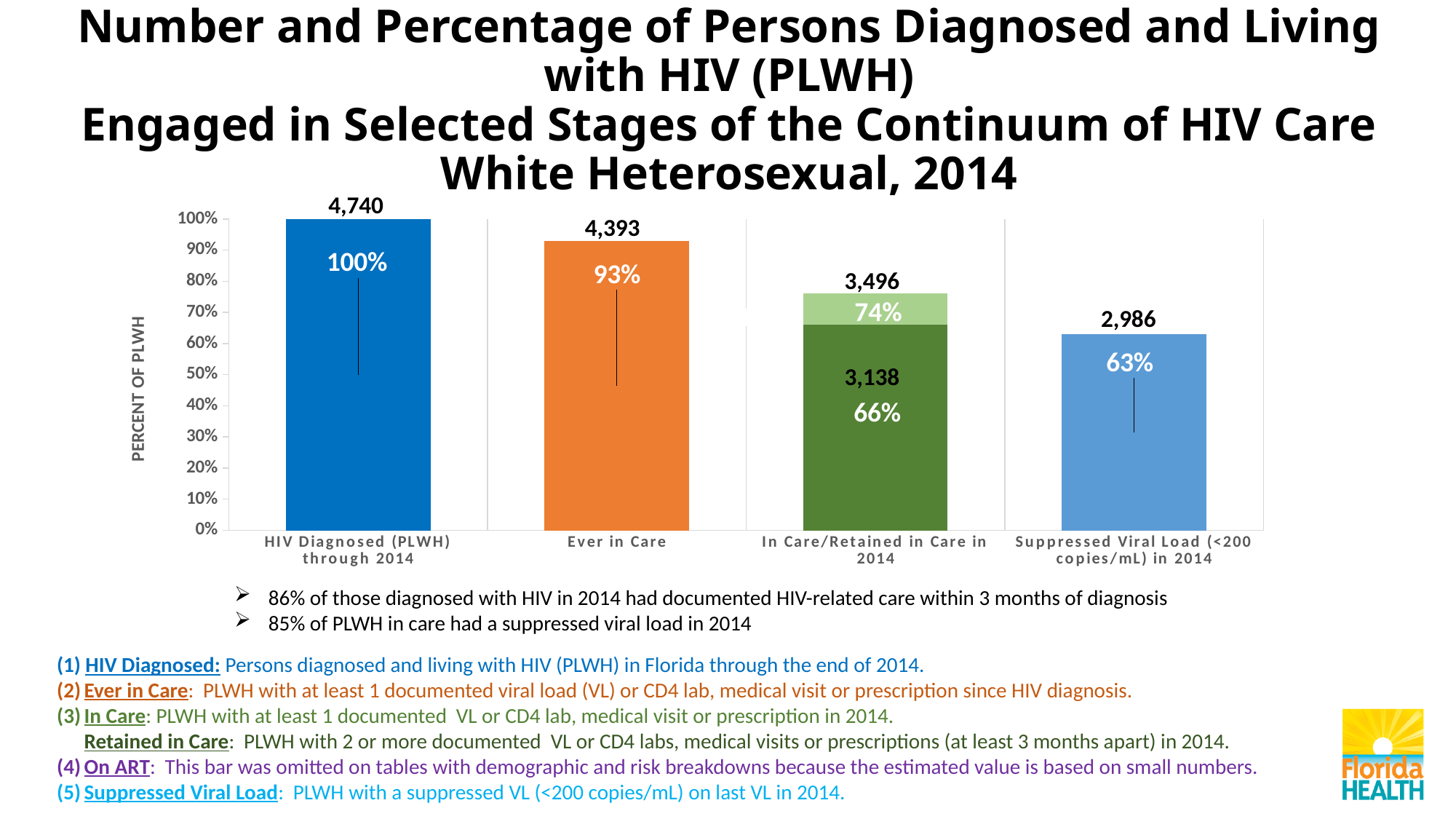
What is the difference in percentage between 'Ever in Care' and 'Suppressed Viral Load (<200 copies/mL) in 2014'? 30% What number is shown for the darker green (Retained in Care) portion of the 'In Care/Retained in Care in 2014' bar? 3,138 What is the difference in number of persons between 'HIV Diagnosed (PLWH) through 2014' and 'Ever in Care'? 347 Which category has the lowest number of persons? Suppressed Viral Load (<200 copies/mL) in 2014 What type of chart is shown on the slide? Bar chart What number is shown at the top of the 'In Care/Retained in Care in 2014' bar? 3,496 What percentage is shown for the 'Ever in Care' bar? 93% Which category has the highest number of persons? HIV Diagnosed (PLWH) through 2014 What percentage is shown for the 'Suppressed Viral Load (<200 copies/mL) in 2014' bar? 63% What is the number of persons shown for the 'HIV Diagnosed (PLWH) through 2014' bar? 4,740 How many categories are shown on the x axis of the chart? 4 Which is larger: the number for 'Ever in Care' or the number for 'In Care/Retained in Care in 2014'? Ever in Care